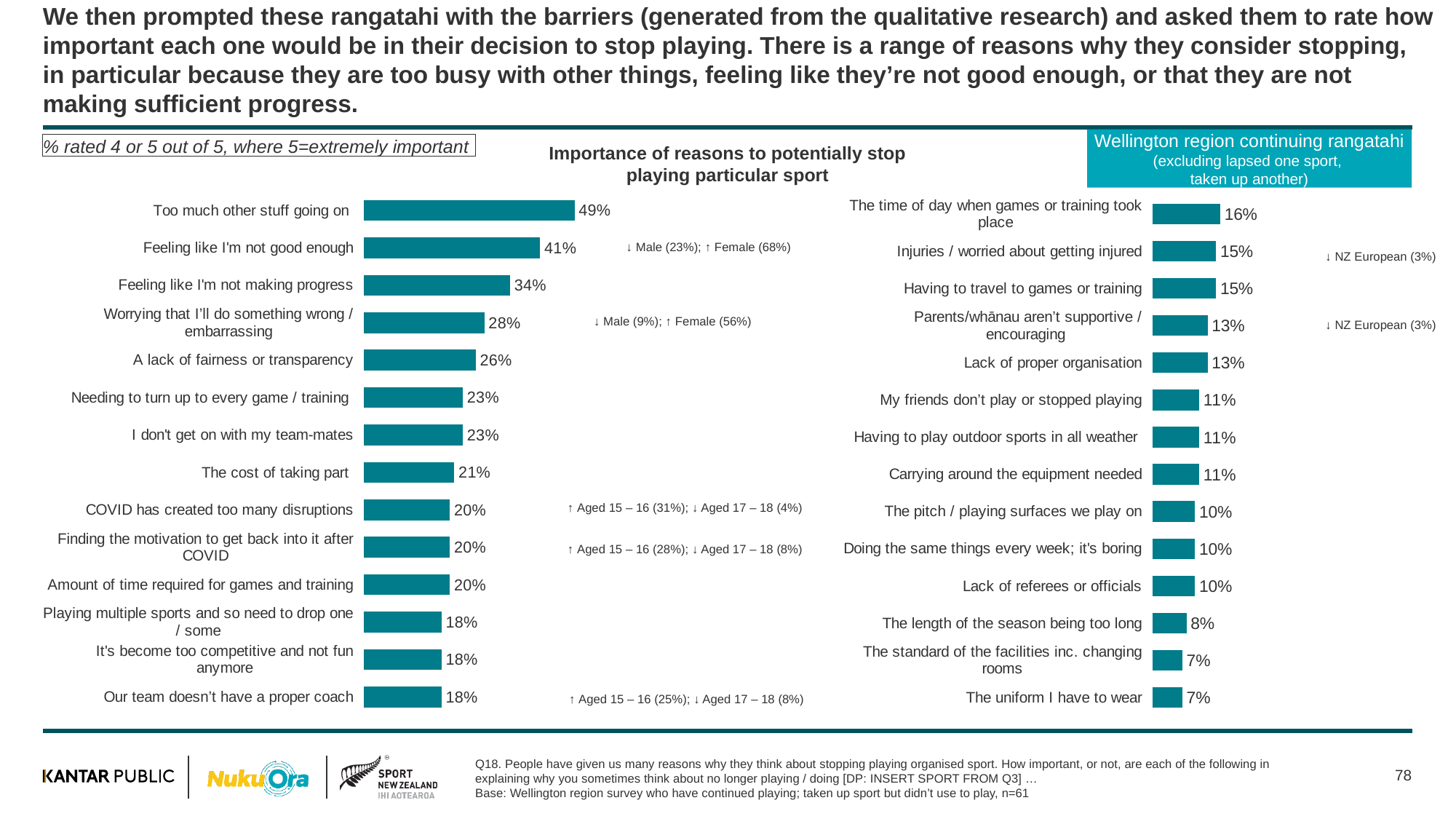
In the left chart, which is larger: 'The cost of taking part' or 'A lack of fairness or transparency'? A lack of fairness or transparency In the right chart, what percentage is shown for 'The uniform I have to wear'? 7% What is the title of the chart on this slide? Importance of reasons to potentially stop playing particular sport In the left chart, what is the difference in percentage points between 'Too much other stuff going on' and 'Feeling like I'm not good enough'? 8 percentage points In the left chart, what percentage is shown for 'Feeling like I'm not making progress'? 34% In the left chart, which reason has the highest percentage? Too much other stuff going on In the right chart, what is the difference in percentage points between 'The time of day when games or training took place' and 'The uniform I have to wear'? 9 percentage points In the right chart, what percentage is shown for 'The length of the season being too long'? 8% In the left chart, what percentage is shown for 'Too much other stuff going on'? 49% In the right chart, which reason has the highest percentage? The time of day when games or training took place How many reasons are listed in the left chart? 14 What type of chart is used on this slide to show the importance of reasons to stop playing? Bar chart